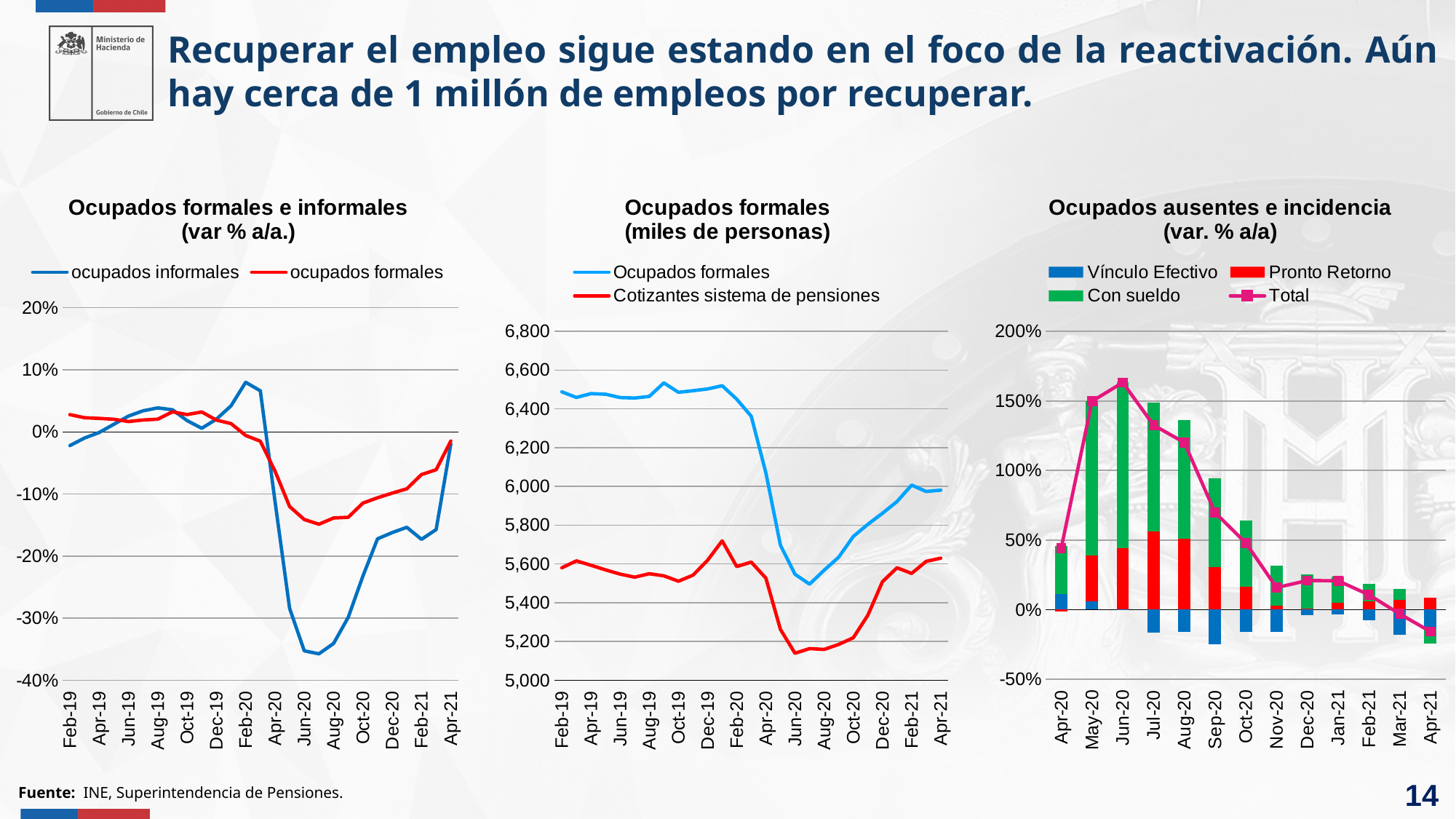
In the left chart 'Ocupados formales e informales', is the value for 'ocupados informales' in Jun-20 greater or less than -30%? less In the right chart 'Ocupados ausentes e incidencia', in which month does the 'Total' line reach its highest value? Jun-20 What kind of chart is the middle chart titled 'Ocupados formales (miles de personas)'? line chart In the right chart 'Ocupados ausentes e incidencia', is the 'Total' value for Jun-20 greater or less than 150%? greater What kind of chart is the left chart titled 'Ocupados formales e informales (var % a/a.)'? line chart In the middle chart 'Ocupados formales (miles de personas)', is the value for 'Ocupados formales' in Feb-19 greater or less than 6,400? greater In the middle chart 'Ocupados formales (miles de personas)', which series is higher in Dec-19, 'Ocupados formales' or 'Cotizantes sistema de pensiones'? Ocupados formales How many series does the legend of the right chart 'Ocupados ausentes e incidencia' list? 4 How many series does the legend of the left chart 'Ocupados formales e informales' list? 2 In the left chart 'Ocupados formales e informales', does the 'ocupados informales' line rise or fall between Feb-20 and Jun-20? fall